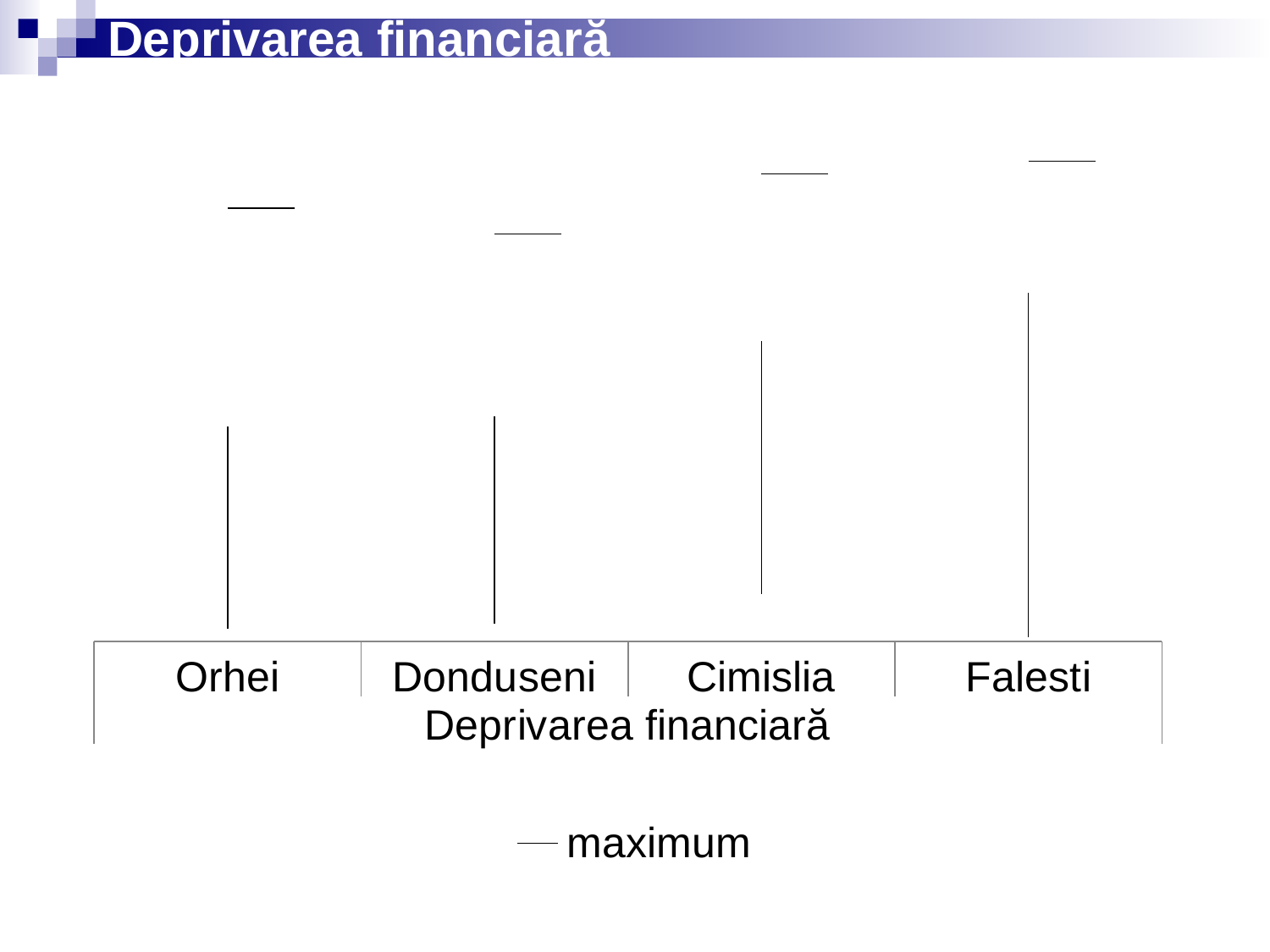
What series name is shown in the chart legend? maximum Is the 'maximum' marker for Orhei higher or lower than the one for Donduseni? higher Which category has the highest 'maximum' marker in the chart? Falesti Which category is listed first on the x axis of the chart? Orhei How many categories are shown on the x axis of the chart? 4 Is the 'maximum' marker for Cimislia higher or lower than the one for Orhei? higher Which category has the lowest 'maximum' marker in the chart? Donduseni What is the title of the chart? Deprivarea financiară How many series does the chart legend list? 1